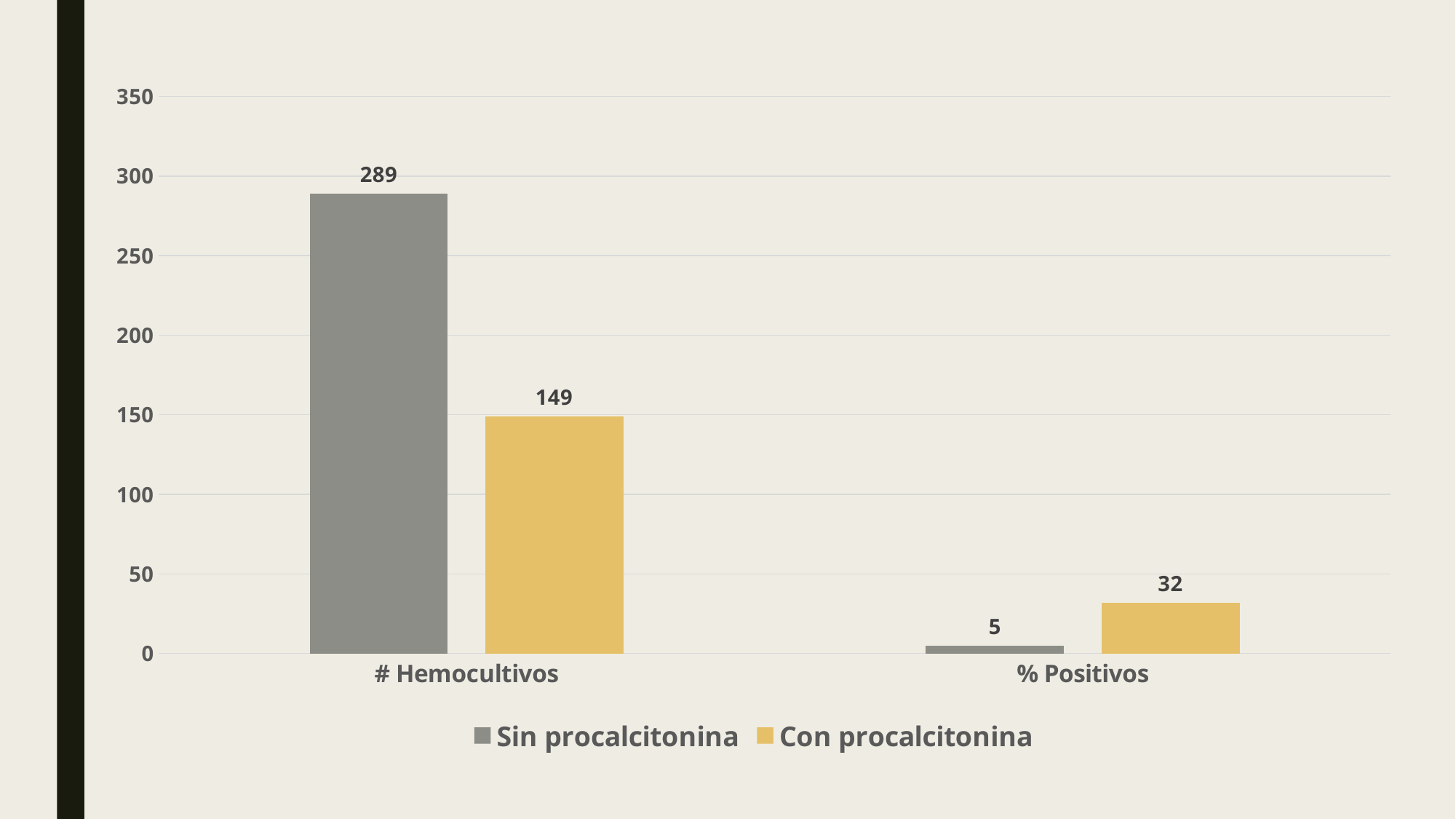
What is the difference between the Sin procalcitonina and Con procalcitonina values for # Hemocultivos? 140 Which bar has the lowest value in the chart? Sin procalcitonina, % Positivos How many series does the legend list? 2 What is the value for Con procalcitonina in the # Hemocultivos category? 149 What is the difference between the Con procalcitonina and Sin procalcitonina values for % Positivos? 27 What is the value for Sin procalcitonina in the # Hemocultivos category? 289 Which series has the higher value in the # Hemocultivos category? Sin procalcitonina Which bar has the highest value in the chart? Sin procalcitonina, # Hemocultivos Which series has the higher value in the % Positivos category? Con procalcitonina What is the value for Sin procalcitonina in the % Positivos category? 5 What kind of chart is shown on the slide? Bar chart What is the value for Con procalcitonina in the % Positivos category? 32